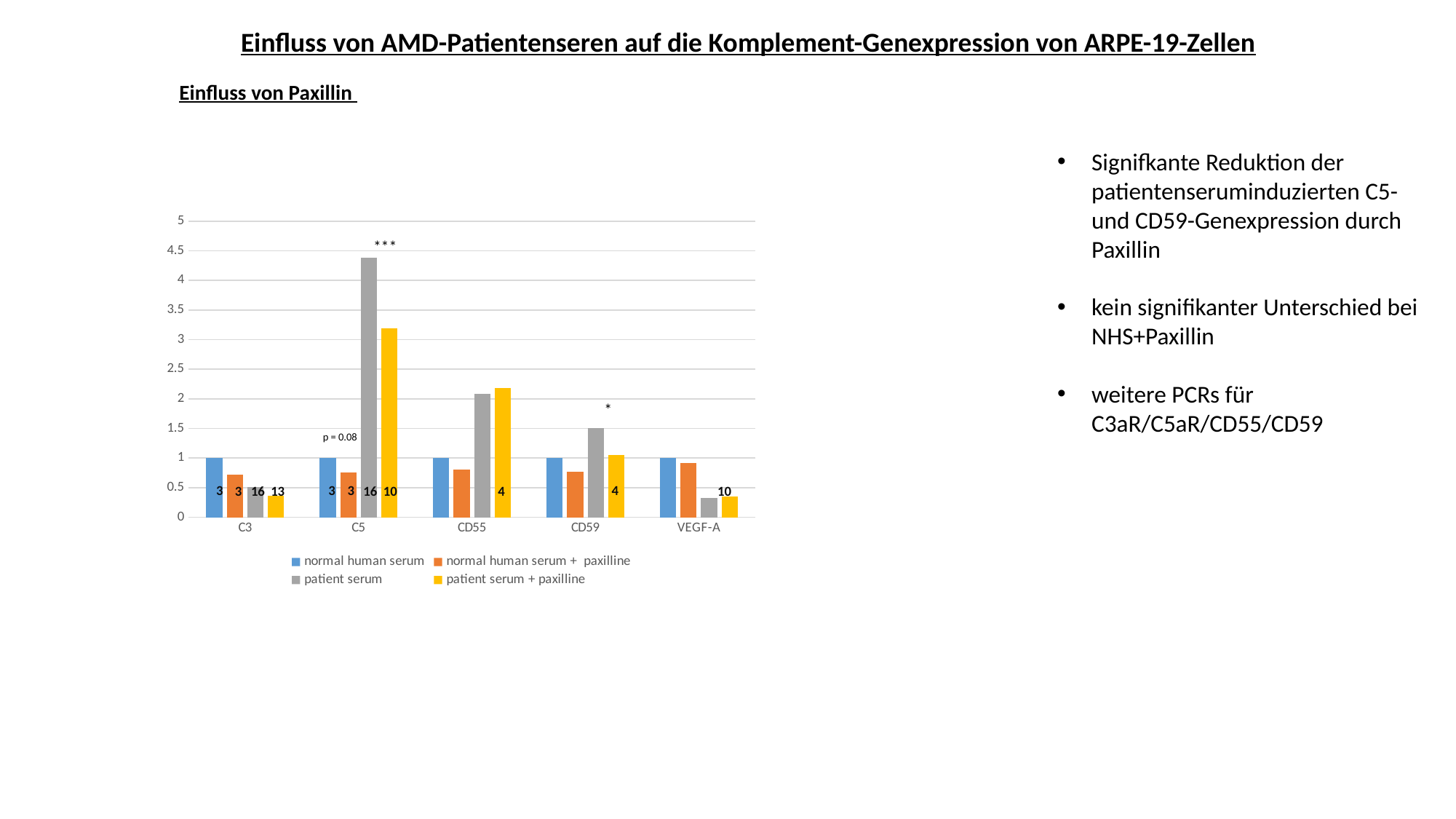
What kind of chart is shown on the slide? bar chart At C5, which is larger: patient serum or patient serum + paxilline? patient serum Is the value for patient serum + paxilline at C5 greater or less than 3? greater What is the value for normal human serum at C5? 1 Is the value for patient serum at C5 greater or less than 4? greater Is the value for patient serum at VEGF-A greater or less than 0.5? less Which category has the highest patient serum bar? C5 How many categories are shown on the x axis of the chart? 5 How many series does the chart legend list? 4 Which category in the chart is marked with three asterisks (***)? C5 What is the value for normal human serum at CD59? 1 Which category has the lowest patient serum bar? VEGF-A